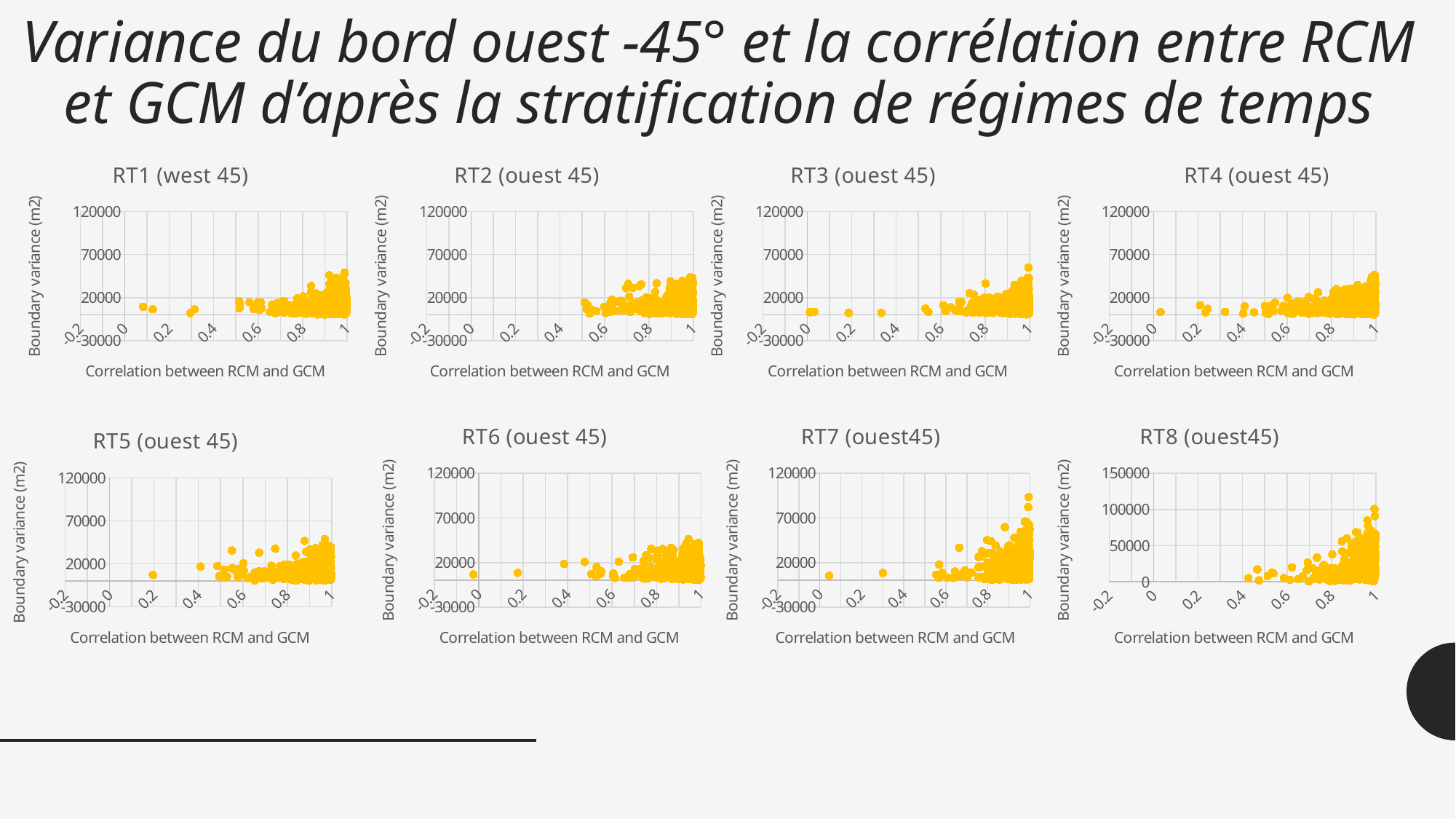
What kind of chart is the RT1 (west 45) chart? Scatter chart In the RT7 (ouest45) chart, is the highest plotted boundary variance greater or less than 70000? greater In the RT7 (ouest45) chart, does the spread of boundary variance values increase or decrease as the correlation approaches 1? increase In the RT1 (west 45) chart, is the highest plotted boundary variance greater or less than 70000? less What is the x-axis label of the RT5 (ouest 45) chart? Correlation between RCM and GCM Which chart on the slide has a y-axis that goes up to 150000 instead of 120000? RT8 (ouest45) In the RT8 (ouest45) chart, does the boundary variance tend to rise or fall as the correlation between RCM and GCM increases toward 1? rise How many charts are shown on the slide? 8 In the RT8 (ouest45) chart, is the highest plotted boundary variance greater or less than 50000? greater